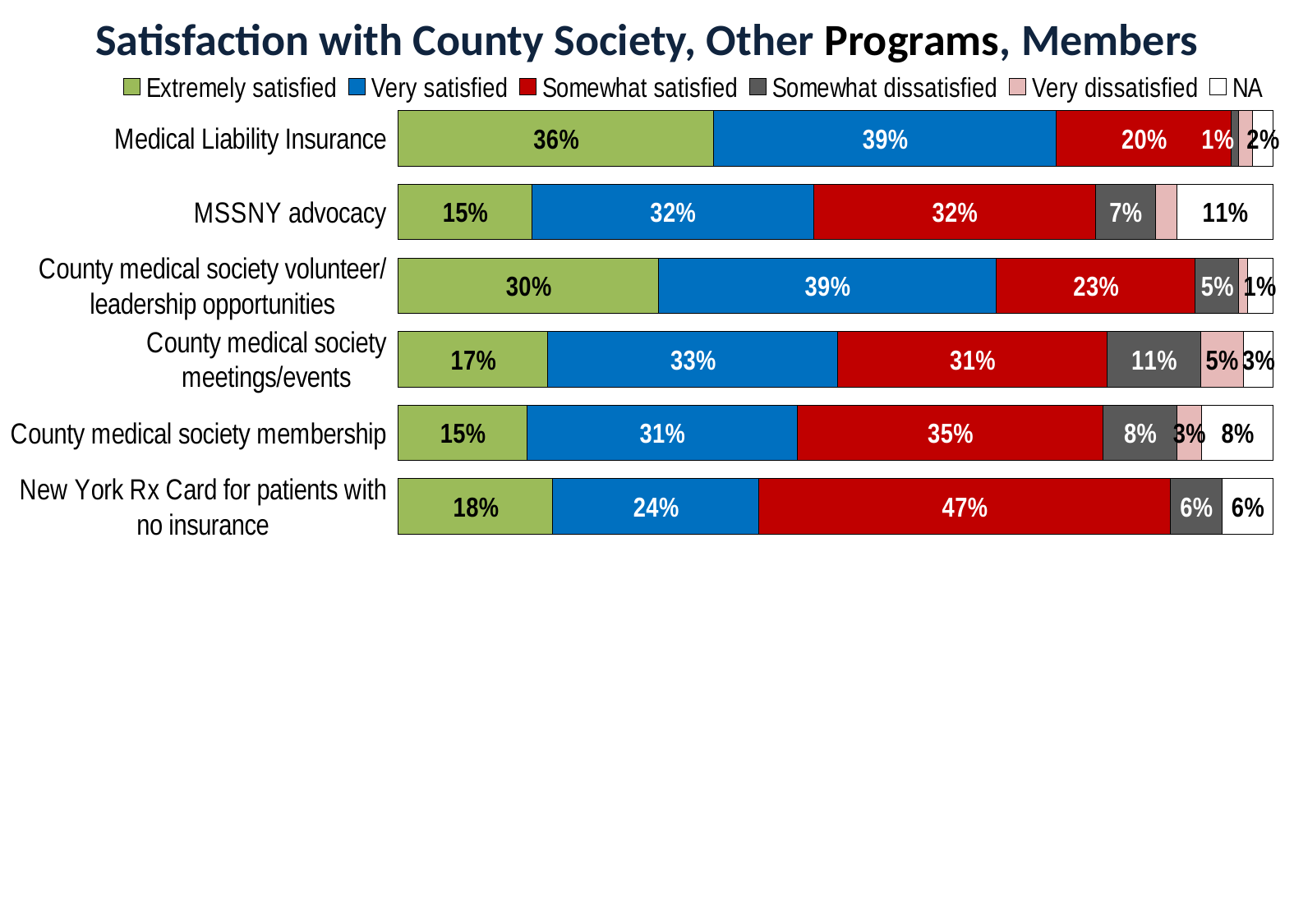
For MSSNY advocacy, how much larger is the Very satisfied value than the Extremely satisfied value? 17 percentage points What percentage of members are Extremely satisfied with Medical Liability Insurance? 36% How many programs (categories) are shown in the chart? 6 Which has a larger Somewhat satisfied value: County medical society membership or County medical society meetings/events? County medical society membership Which program has the highest Somewhat satisfied percentage? New York Rx Card for patients with no insurance Which program has the highest Extremely satisfied percentage? Medical Liability Insurance What is the Somewhat satisfied value for New York Rx Card for patients with no insurance? 47% What is the Somewhat dissatisfied value for County medical society meetings/events? 11% How many series does the legend list? 6 Which program has the lowest Very satisfied percentage? New York Rx Card for patients with no insurance What kind of chart is shown on the slide? Stacked bar chart What is the NA value for MSSNY advocacy? 11%